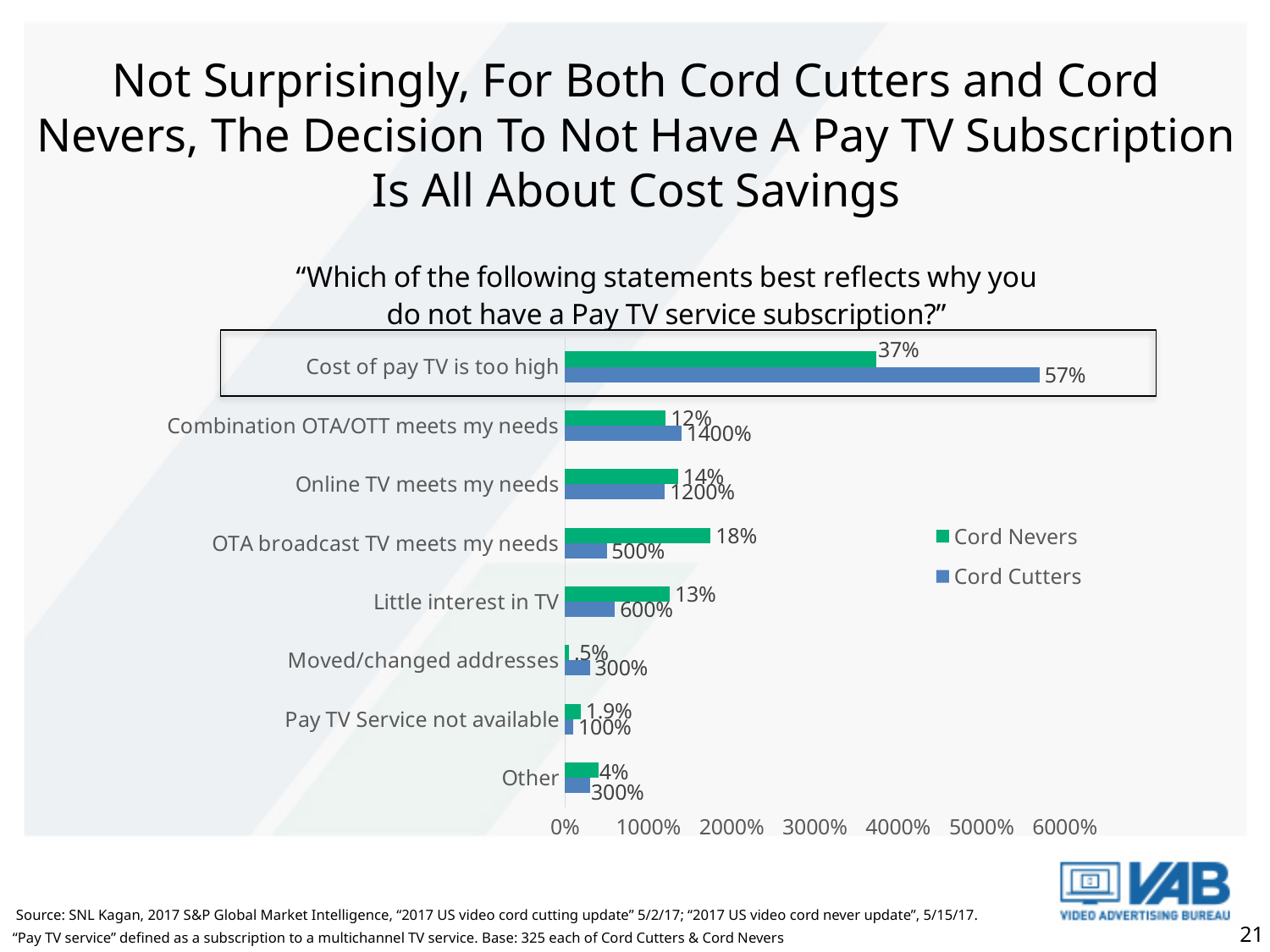
Which category has the lowest Cord Nevers value? Moved/changed addresses What is the difference between the Cord Nevers values for "Cost of pay TV is too high" and "OTA broadcast TV meets my needs"? 19% Which category has the longest Cord Cutters bar? Cost of pay TV is too high What is the Cord Cutters data label for "Combination OTA/OTT meets my needs"? 1400% What is the Cord Nevers value for "OTA broadcast TV meets my needs"? 18% For Cord Nevers, which is larger: "OTA broadcast TV meets my needs" or "Online TV meets my needs"? OTA broadcast TV meets my needs How many categories are shown on the chart? 8 How many series does the legend list? 2 What is the Cord Cutters value for "Cost of pay TV is too high"? 57% Is the Cord Cutters bar for "Cost of pay TV is too high" greater or less than 5000% on the axis? greater What is the Cord Nevers value for "Cost of pay TV is too high"? 37% Which category has the highest Cord Nevers value? Cost of pay TV is too high